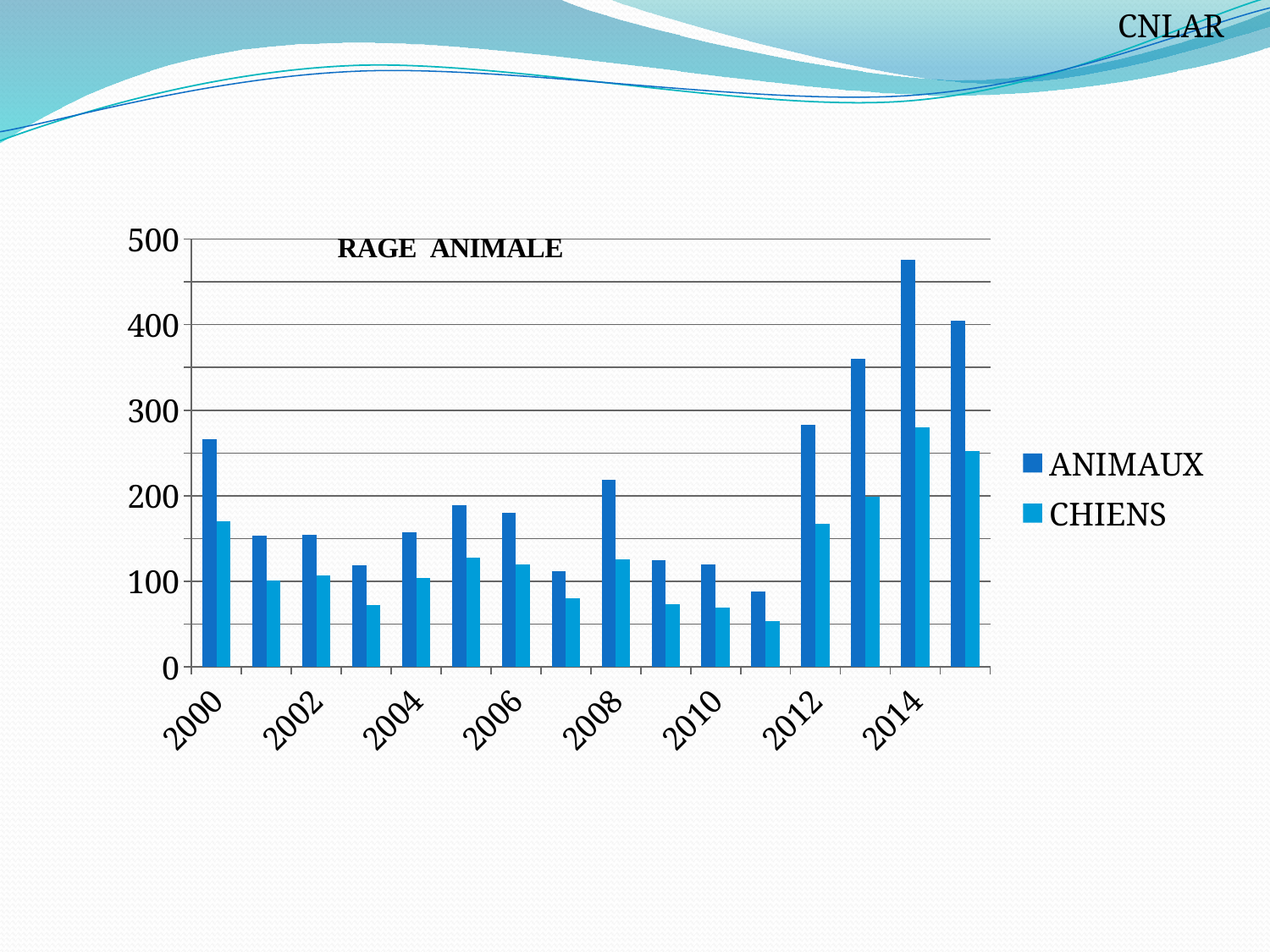
Is the ANIMAUX value for 2014 greater or less than 400? greater In which year is the CHIENS value highest? 2014 Which series is shown in the lighter blue colour? CHIENS In which year is the ANIMAUX value highest? 2014 Is the CHIENS value for 2014 greater or less than 300? less What type of chart is shown on the slide? bar chart What is the title of the chart? RAGE ANIMALE Which is larger, the ANIMAUX value for 2014 or the ANIMAUX value for 2012? 2014 Is the CHIENS value for 2010 greater or less than 100? less Do the ANIMAUX values rise or fall from 2011 to 2014? rise How many series does the legend list? 2